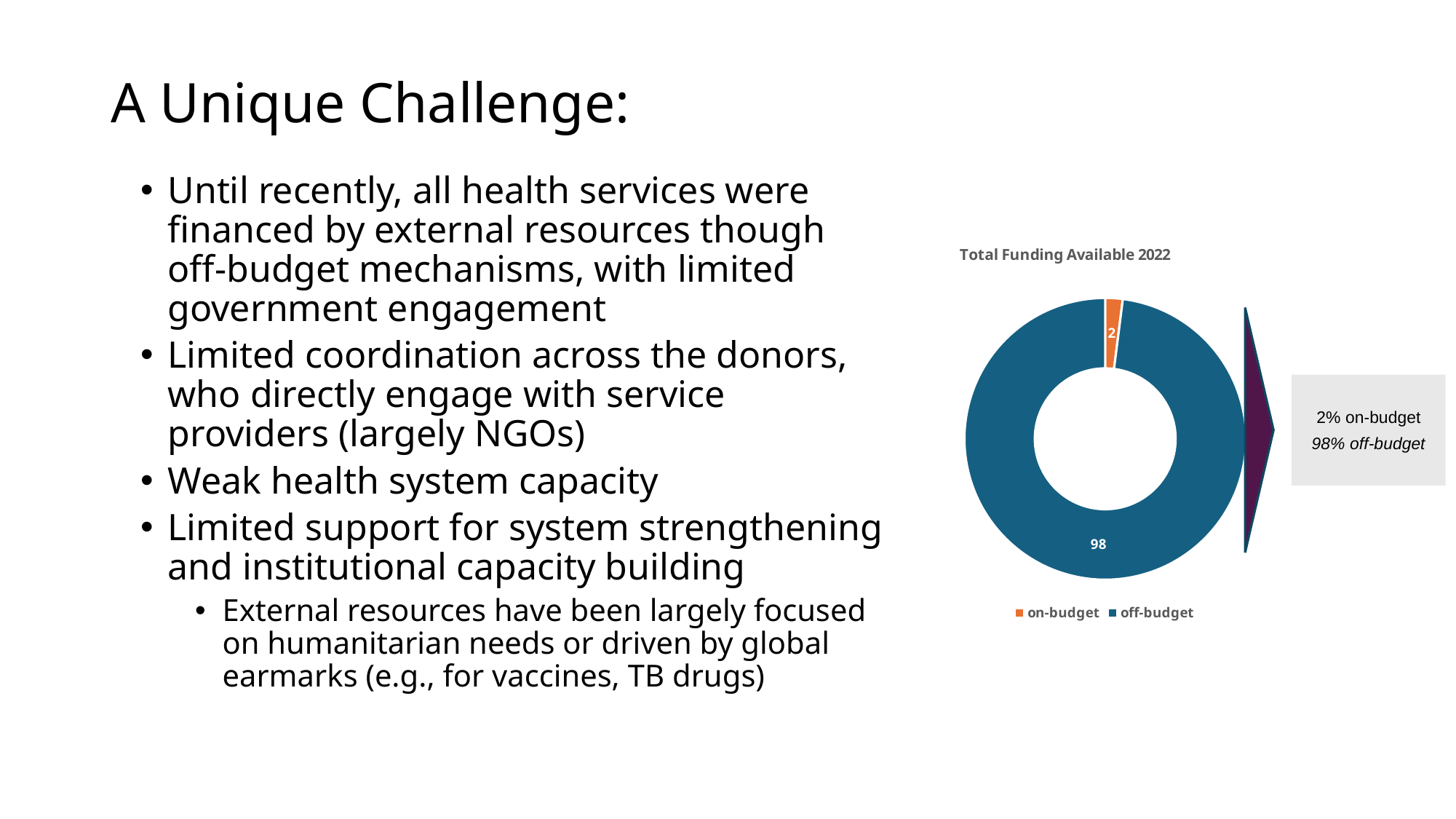
Which category has the largest slice in the chart? off-budget How many entries does the legend list? 2 What kind of chart is shown on the slide? doughnut chart Which category has the smallest slice in the chart? on-budget What colour is the off-budget slice? blue Which is larger, on-budget or off-budget? off-budget How many categories does the chart show? 2 What is the title of the chart? Total Funding Available 2022 What is the difference between the off-budget and on-budget values? 96 What is the value shown for off-budget in the chart? 98 What is the value shown for on-budget in the chart? 2 What share of the total does the on-budget slice represent? 2%